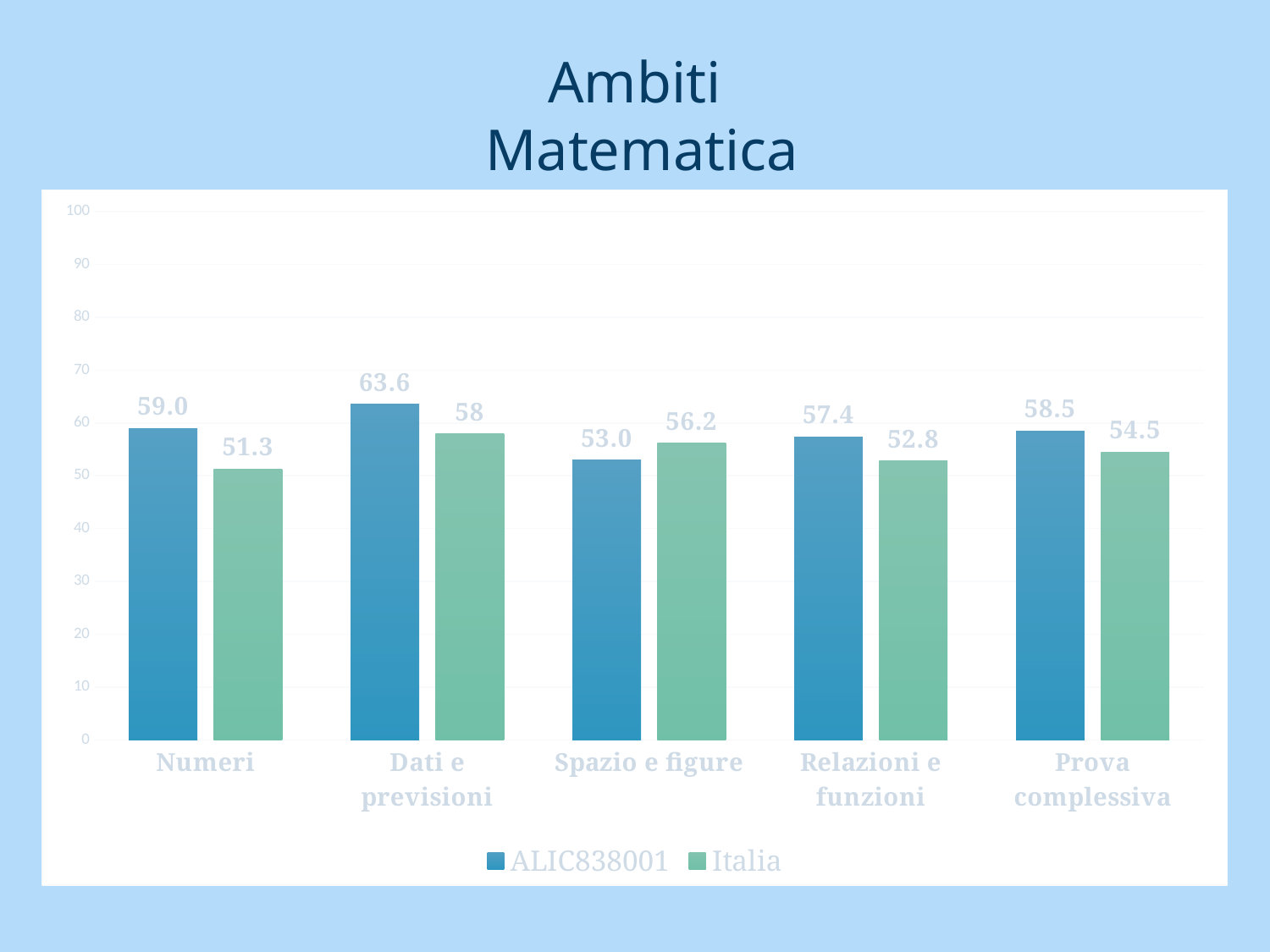
Which category has the lowest value for Italia? Numeri What is the difference between ALIC838001 and Italia in the Numeri category? 7.7 Which is larger in the Spazio e figure category, ALIC838001 or Italia? Italia How many series does the legend list? 2 What kind of chart is shown on the slide? bar chart How many categories are shown on the x axis? 5 Which category has the highest value for ALIC838001? Dati e previsioni What is the title of the slide? Ambiti Matematica What is the value for Italia in the Dati e previsioni category? 58 What is the value for ALIC838001 in the Numeri category? 59.0 What is the value for Italia in the Prova complessiva category? 54.5 Is the value for ALIC838001 in Dati e previsioni greater or less than 60? greater